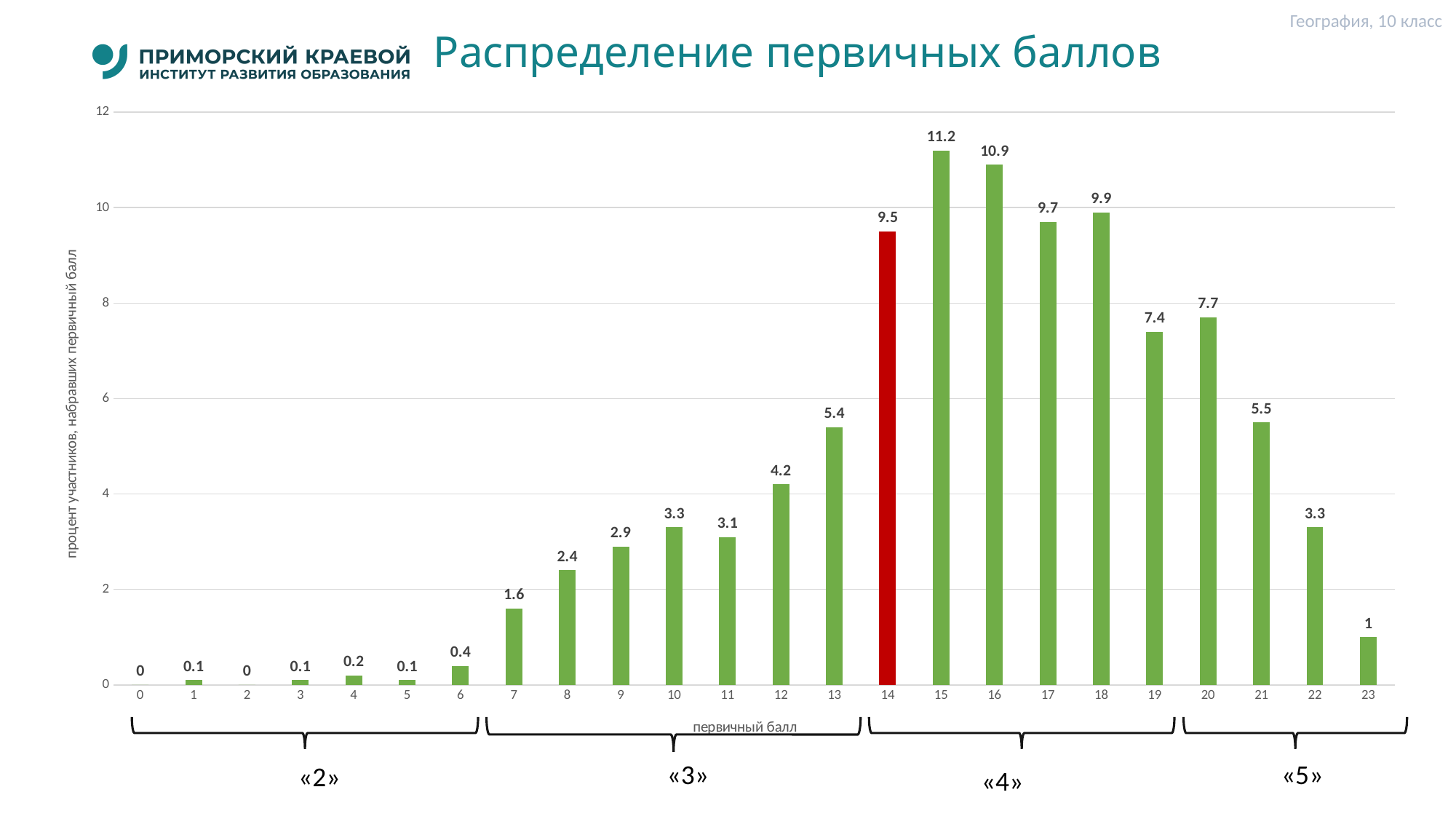
Is the value for primary score 19 greater or less than 6? greater What is the difference between the values for primary scores 14 and 13? 4.1 Which primary score is shown with a red bar? 14 What kind of chart is shown on the slide? bar chart What is the value for primary score 15? 11.2 Which has the larger value, primary score 17 or primary score 18? 18 What is the value for primary score 7? 1.6 What is the value for primary score 14, the red bar? 9.5 Which primary score has the highest value? 15 How many primary score categories are shown on the x axis? 24 What is the difference between the values for primary scores 15 and 16? 0.3